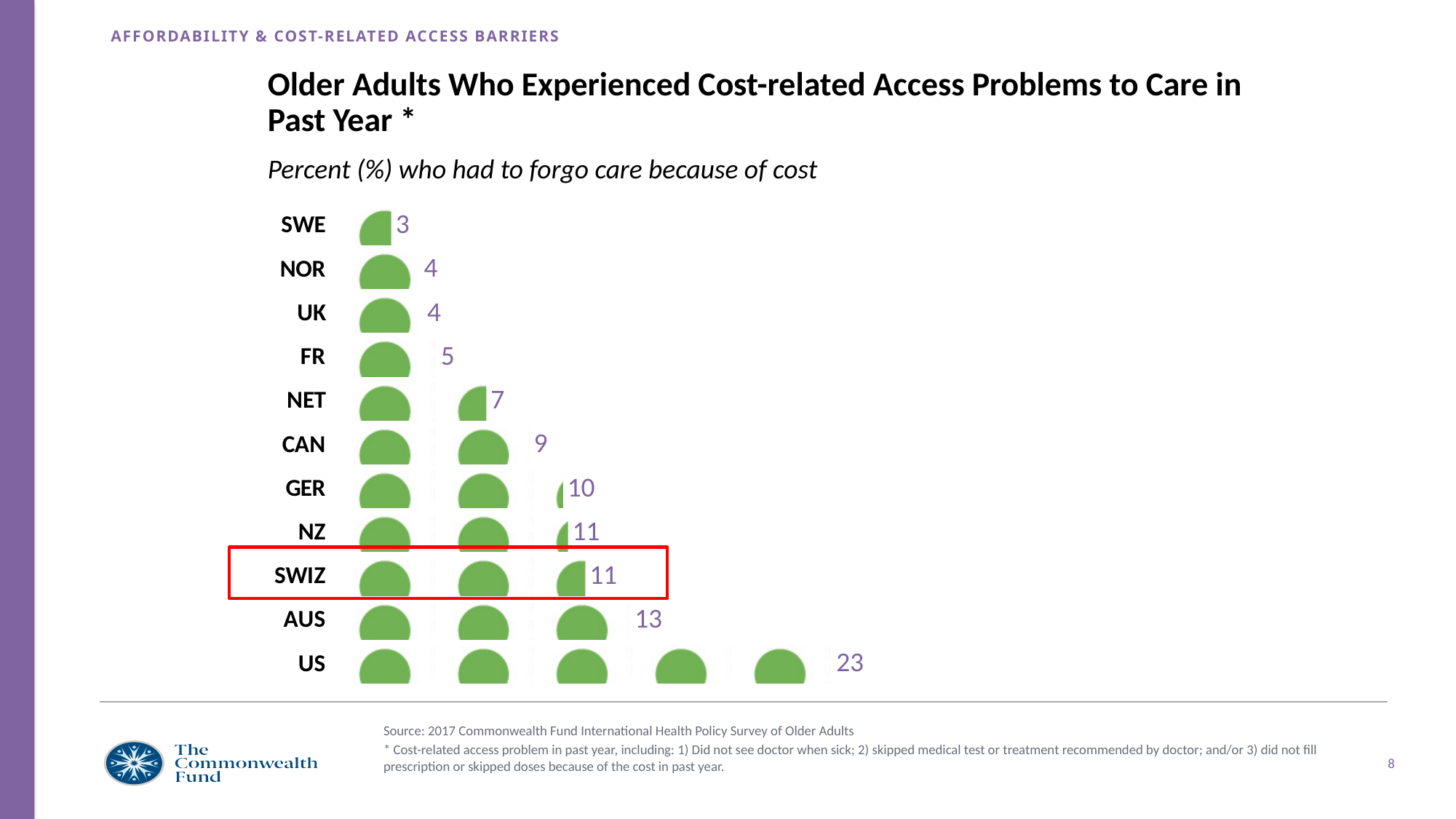
Which country has the highest value? US What is the value for SWIZ? 11 What is the difference between the values for GER and FR? 5 Which country is highlighted with a red box? SWIZ Which has a larger value, AUS or NZ? AUS What is the difference between the values for the US and AUS? 10 Which country has the lowest value? SWE What is the value for CAN? 9 What kind of chart is this? bar chart What is the value for NET? 7 How many countries are shown in the chart? 11 What is the value for the US? 23